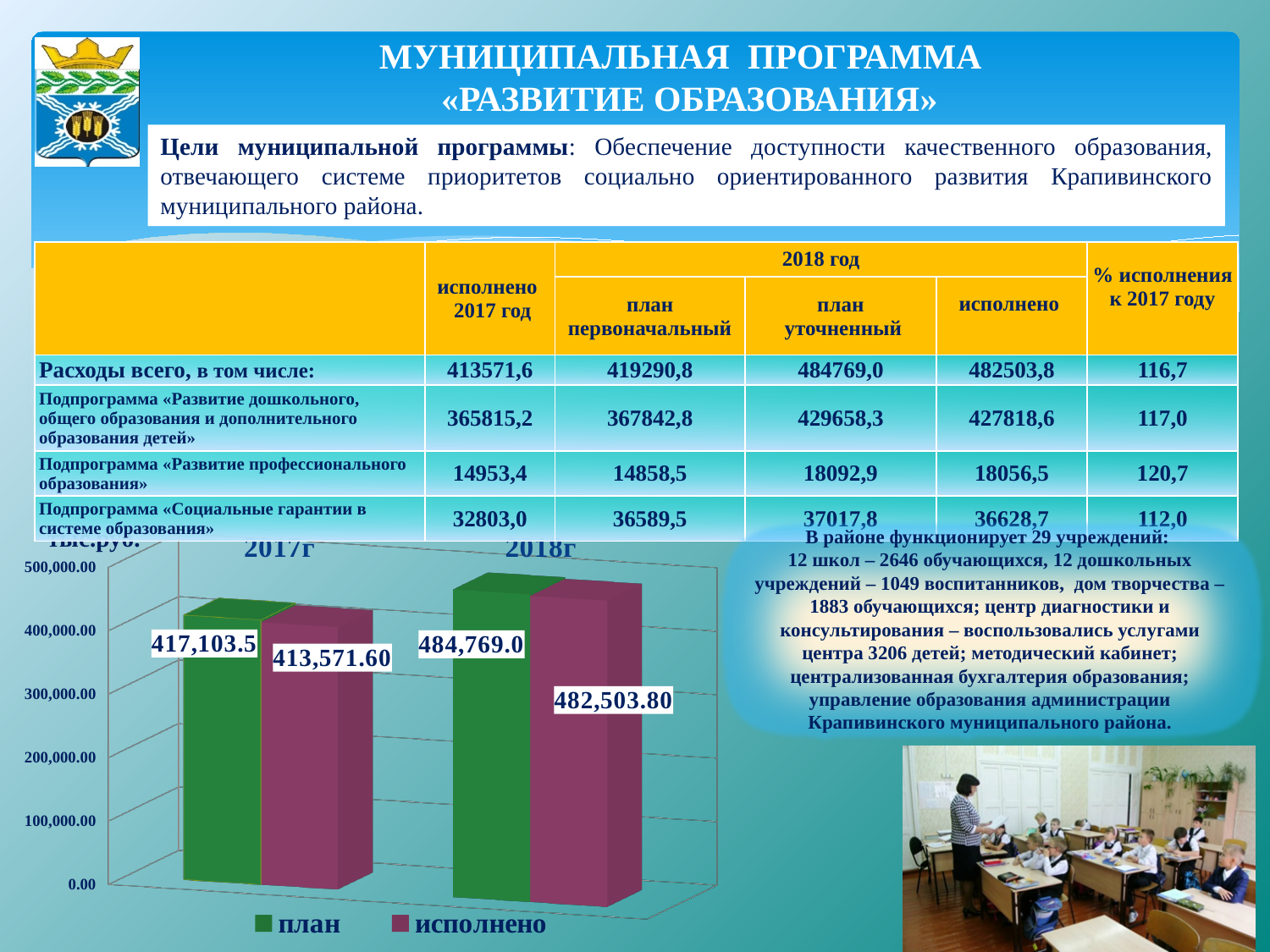
In the bar chart, what is the value of план for 2017г? 417,103.5 In the bar chart, which year has the higher исполнено value? 2018г In the bar chart, what is the value of план for 2018г? 484,769.0 In the bar chart, which colour represents the исполнено series? purple In the bar chart, is the value of план for 2018г greater or less than 400,000.00? greater In the bar chart, what is the value of исполнено for 2018г? 482,503.80 In the bar chart, what is the value of исполнено for 2017г? 413,571.60 In the bar chart, which bar has the lowest value overall? исполнено for 2017г How many series does the legend of the bar chart list? 2 In the bar chart, what is the difference between план and исполнено for 2018г? 2,265.2 In the bar chart, what is the difference between план for 2018г and план for 2017г? 67,665.5 What type of chart is shown at the bottom left of the slide? bar chart